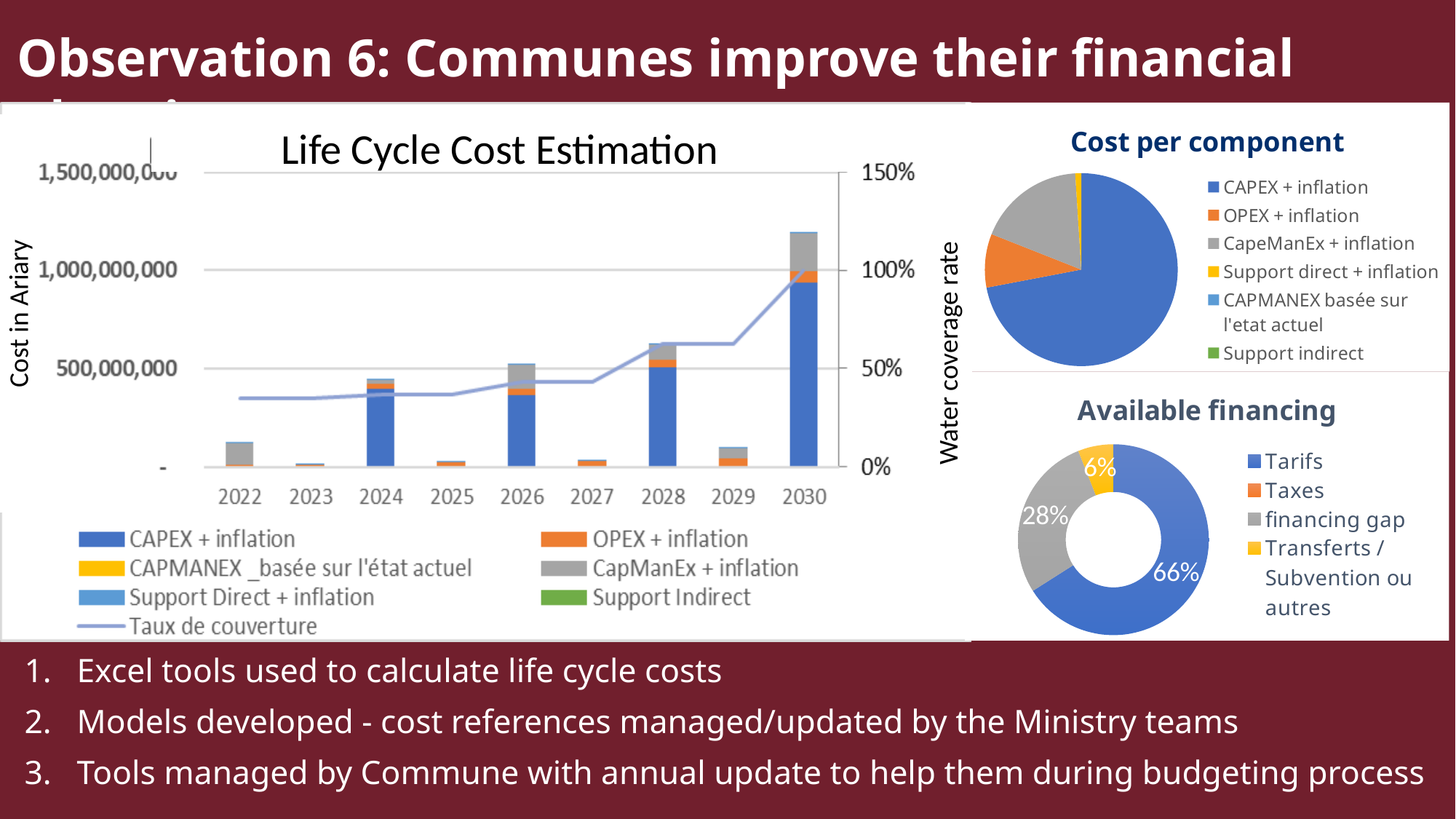
In the Life Cycle Cost Estimation chart, how many entries does the legend list? 7 In the Available financing chart, what is the difference in percentage points between Tarifs and financing gap? 38 In the Life Cycle Cost Estimation chart, is the total bar for 2030 greater or less than 1,000,000,000? greater In the Life Cycle Cost Estimation chart, which year has the highest total bar? 2030 In the Life Cycle Cost Estimation chart, does the Taux de couverture line generally rise or fall from 2022 to 2030? rise In the Cost per component chart, how many entries does the legend list? 6 In the Available financing chart, what share is Tarifs? 66% In the Life Cycle Cost Estimation chart, how many years are shown on the x axis? 9 In the Life Cycle Cost Estimation chart, is the total bar for 2024 greater or less than 500,000,000? less In the Life Cycle Cost Estimation chart, what is the label of the left vertical axis? Cost in Ariary In the Life Cycle Cost Estimation chart, which year has a taller total bar, 2026 or 2028? 2028 In the Cost per component chart, which component has the largest slice? CAPEX + inflation